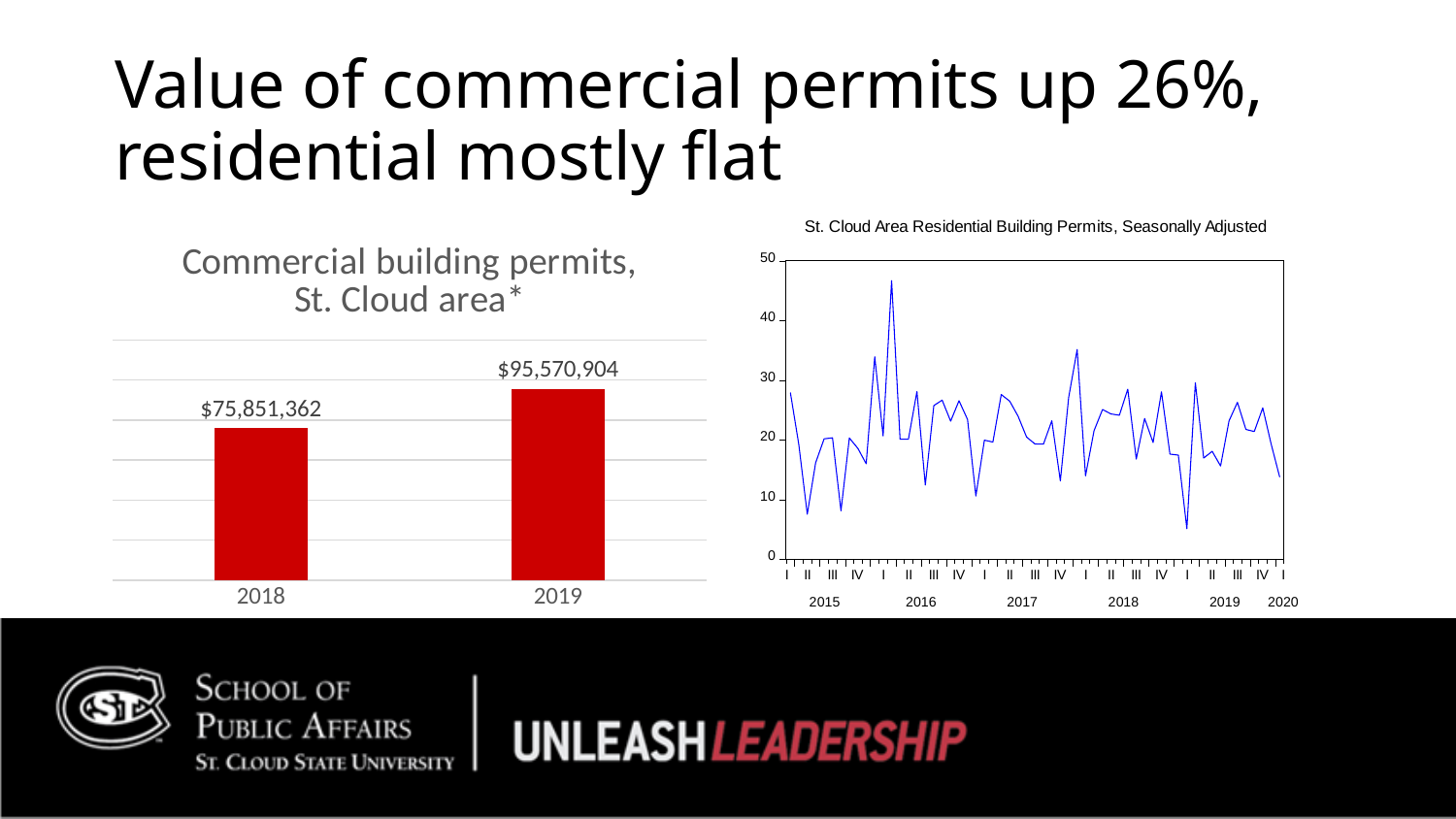
On the St. Cloud Area Residential Building Permits chart, is the highest point on the line greater or less than 40? greater What kind of chart is the St. Cloud Area Residential Building Permits chart? Line chart What kind of chart is the Commercial building permits chart? Bar chart On the Commercial building permits chart, how many bars are plotted? 2 On the Commercial building permits chart, which year has the higher value? 2019 On the St. Cloud Area Residential Building Permits chart, is the lowest point on the line greater or less than 10? less On the Commercial building permits chart, what is the value for 2019? $95,570,904 On the Commercial building permits chart, what is the value for 2018? $75,851,362 On the Commercial building permits chart, which year has the lower value? 2018 On the St. Cloud Area Residential Building Permits chart, how many years are labeled on the x axis? 6 On the Commercial building permits chart, what is the difference between the 2019 and 2018 values? $19,719,542 What is the title of the line chart on the right side of the slide? St. Cloud Area Residential Building Permits, Seasonally Adjusted